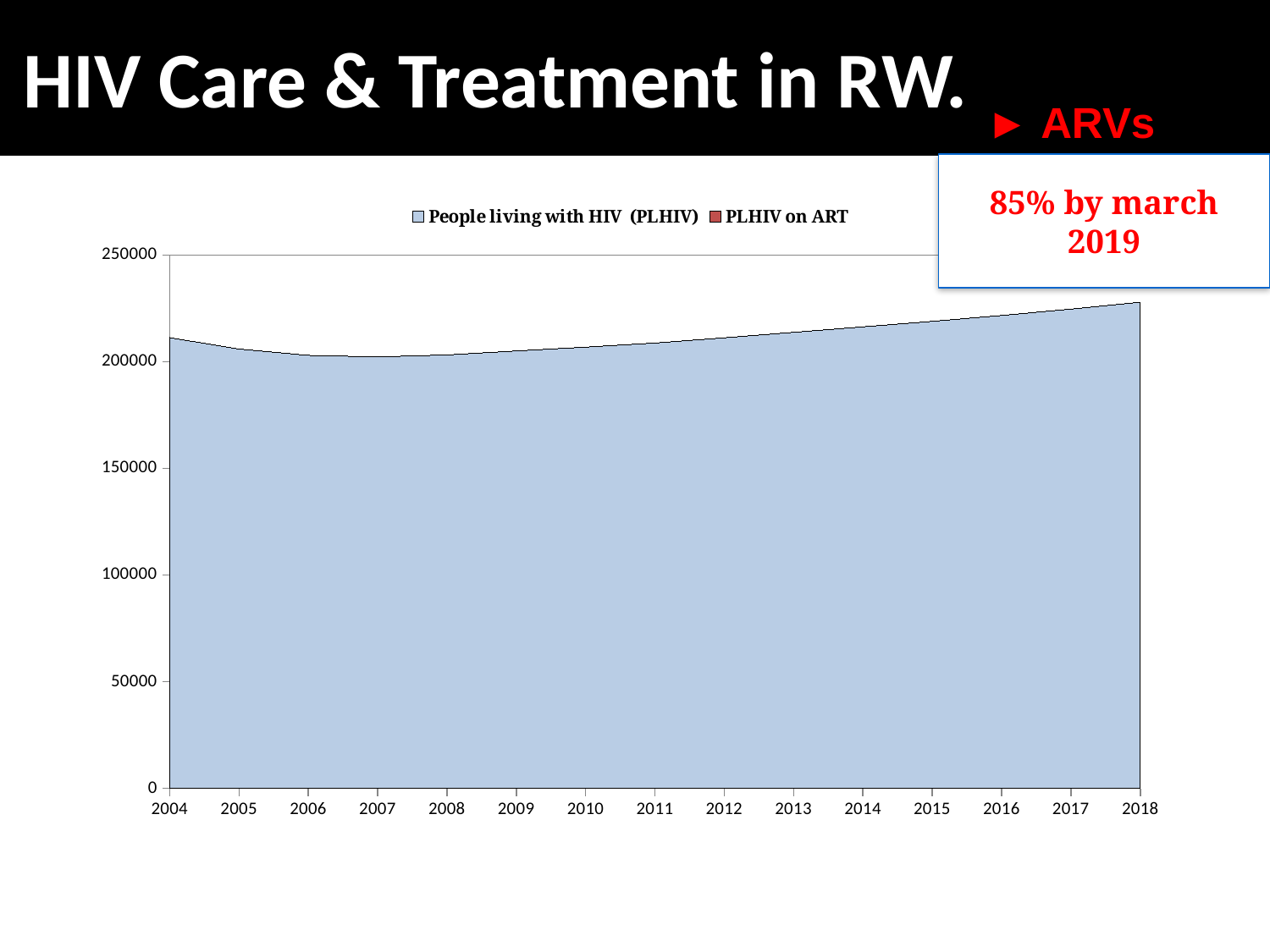
How many series does the chart legend list? 2 Which year has the highest value for People living with HIV (PLHIV)? 2018 What is the first series listed in the chart legend? People living with HIV (PLHIV) What kind of chart is shown on the slide? Area chart How many years are shown along the x axis of the chart? 15 Is the value for People living with HIV (PLHIV) in 2018 greater or less than 250000? less Which year has the larger value for People living with HIV (PLHIV), 2004 or 2007? 2004 Is the value for People living with HIV (PLHIV) in 2010 greater or less than 150000? greater Is the value for People living with HIV (PLHIV) in 2018 greater or less than 200000? greater Do the values for People living with HIV (PLHIV) rise or fall from 2007 to 2018? Rise Which year has the larger value for People living with HIV (PLHIV), 2004 or 2018? 2018